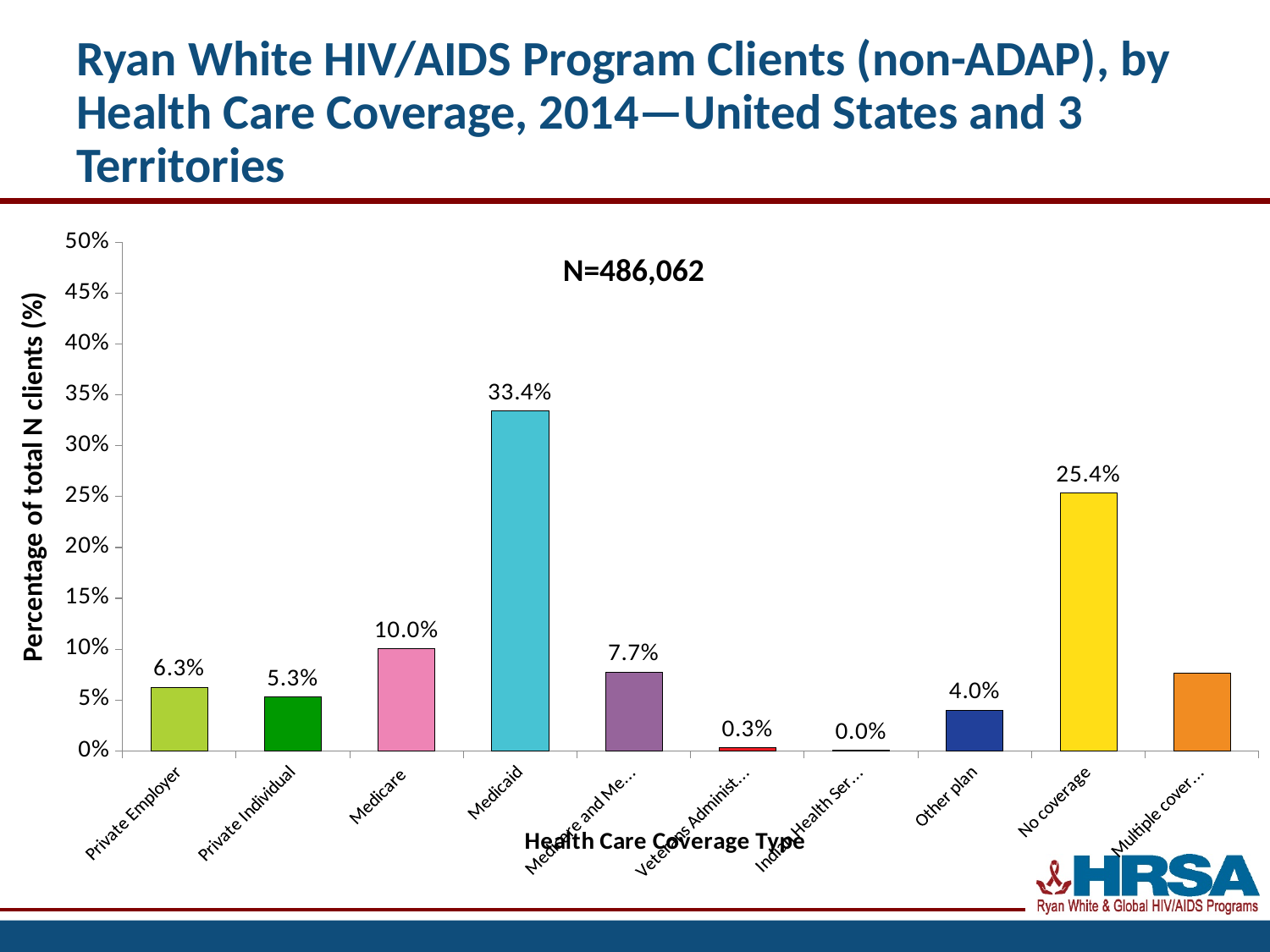
What is the total N of clients stated on the chart? N=486,062 What is the value shown for Other plan? 4.0% Which is larger, the value for Private Employer or the value for Private Individual? Private Employer What percentage of clients have Medicaid coverage? 33.4% What kind of chart is shown on the slide? Bar chart Which health care coverage type has the highest percentage of clients? Medicaid What is the difference in percentage points between Medicaid and No coverage? 8.0 How many health care coverage types are shown on the x axis? 10 What is the value shown for No coverage? 25.4% What is the difference in percentage points between Medicare and Private Employer? 3.7 What percentage of clients have Private Employer coverage? 6.3% Is the value for the last bar (Multiple coverage) greater or less than 5%? greater